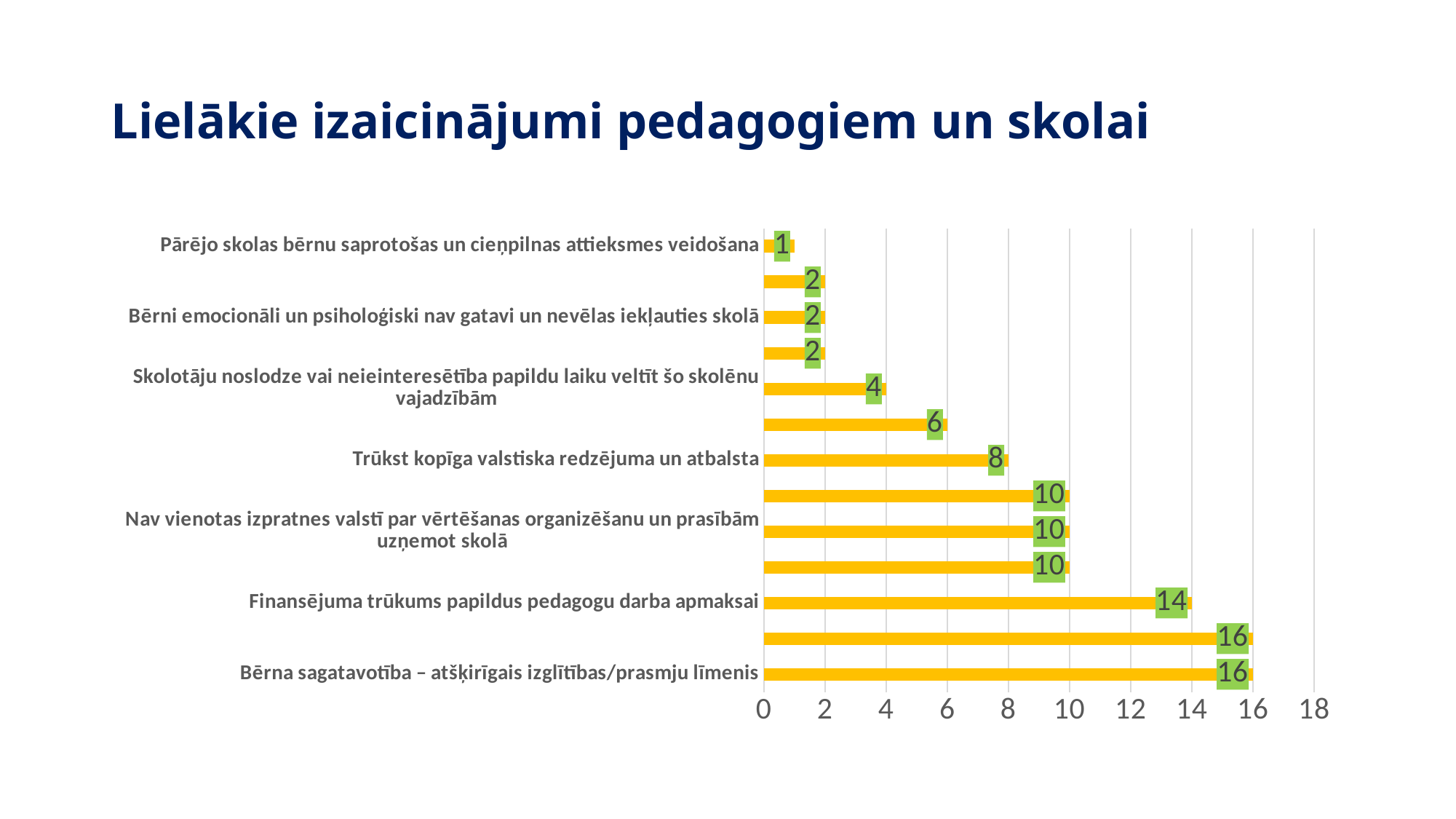
What is the value for "Nav vienotas izpratnes valstī par vērtēšanas organizēšanu un prasībām uzņemot skolā"? 10 What is the highest value shown by any bar in the chart? 16 Which is larger: the value for "Bērni emocionāli un psiholoģiski nav gatavi un nevēlas iekļauties skolā" or the value for "Skolotāju noslodze vai neieinteresētība papildu laiku veltīt šo skolēnu vajadzībām"? Skolotāju noslodze vai neieinteresētība papildu laiku veltīt šo skolēnu vajadzībām Which category has the lowest value in the chart? Pārējo skolas bērnu saprotošas un cieņpilnas attieksmes veidošana What is the value for "Skolotāju noslodze vai neieinteresētība papildu laiku veltīt šo skolēnu vajadzībām"? 4 What is the difference between the values for "Finansējuma trūkums papildus pedagogu darba apmaksai" and "Trūkst kopīga valstiska redzējuma un atbalsta"? 6 How many bars are plotted in the chart? 13 What is the value for "Finansējuma trūkums papildus pedagogu darba apmaksai"? 14 What is the value for "Bērna sagatavotība – atšķirīgais izglītības/prasmju līmenis"? 16 What kind of chart is shown on the slide? Bar chart What is the value for "Trūkst kopīga valstiska redzējuma un atbalsta"? 8 What is the title of the slide? Lielākie izaicinājumi pedagogiem un skolai